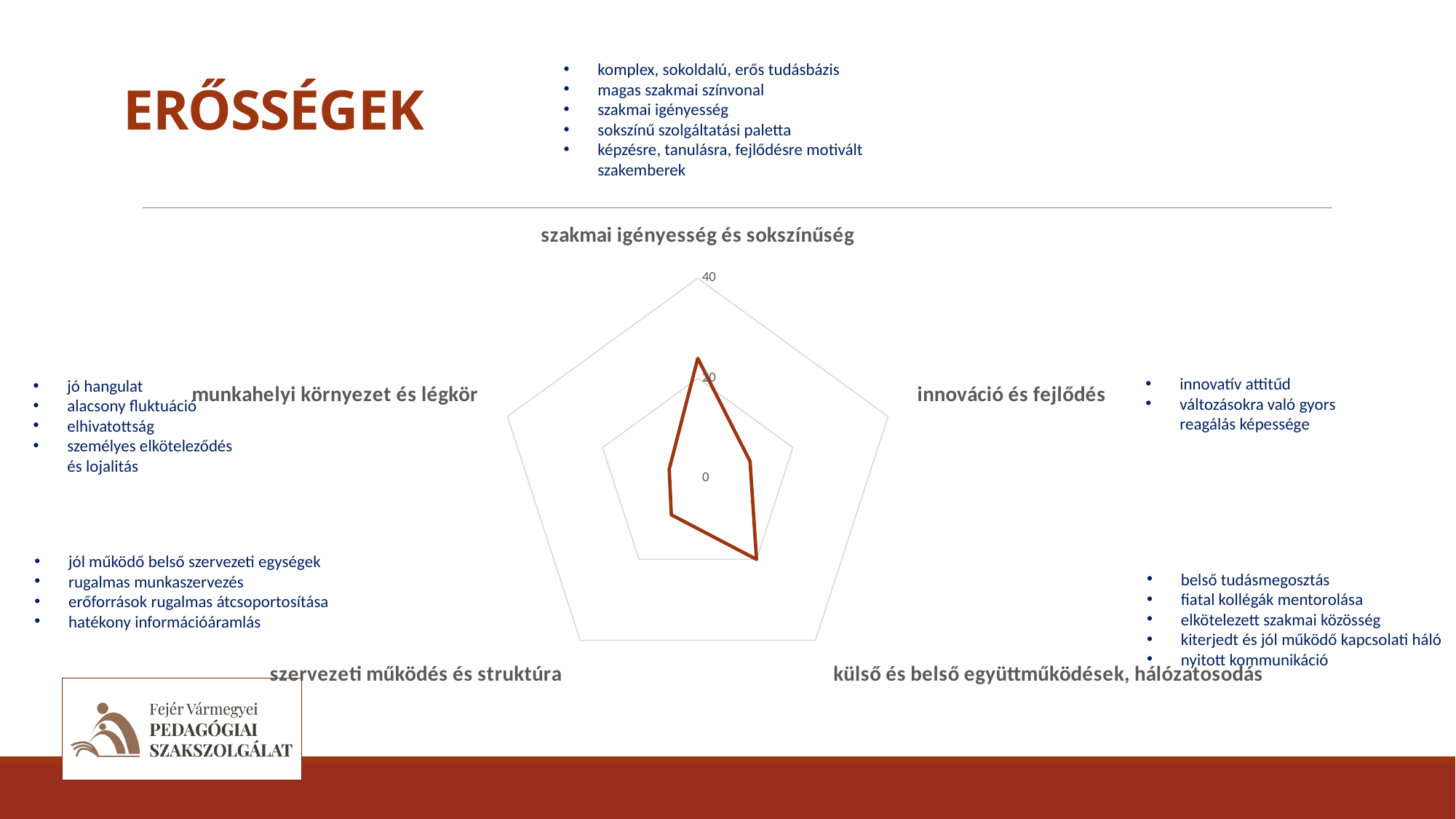
What is the maximum value shown on the radar chart's axis scale? 40 What kind of chart is shown on the slide? radar chart What colour is the data line plotted on the radar chart? dark red Which is larger: the value for külső és belső együttműködések, hálózatosodás or the value for munkahelyi környezet és légkör? külső és belső együttműködések, hálózatosodás Which category has the highest value in the radar chart? szakmai igényesség és sokszínűség Which is larger: the value for szakmai igényesség és sokszínűség or the value for innováció és fejlődés? szakmai igényesség és sokszínűség How many categories (axes) does the radar chart have? 5 Is the value for innováció és fejlődés greater or less than 20? less Is the value for munkahelyi környezet és légkör greater or less than 20? less Is the value for külső és belső együttműködések, hálózatosodás greater or less than 40? less